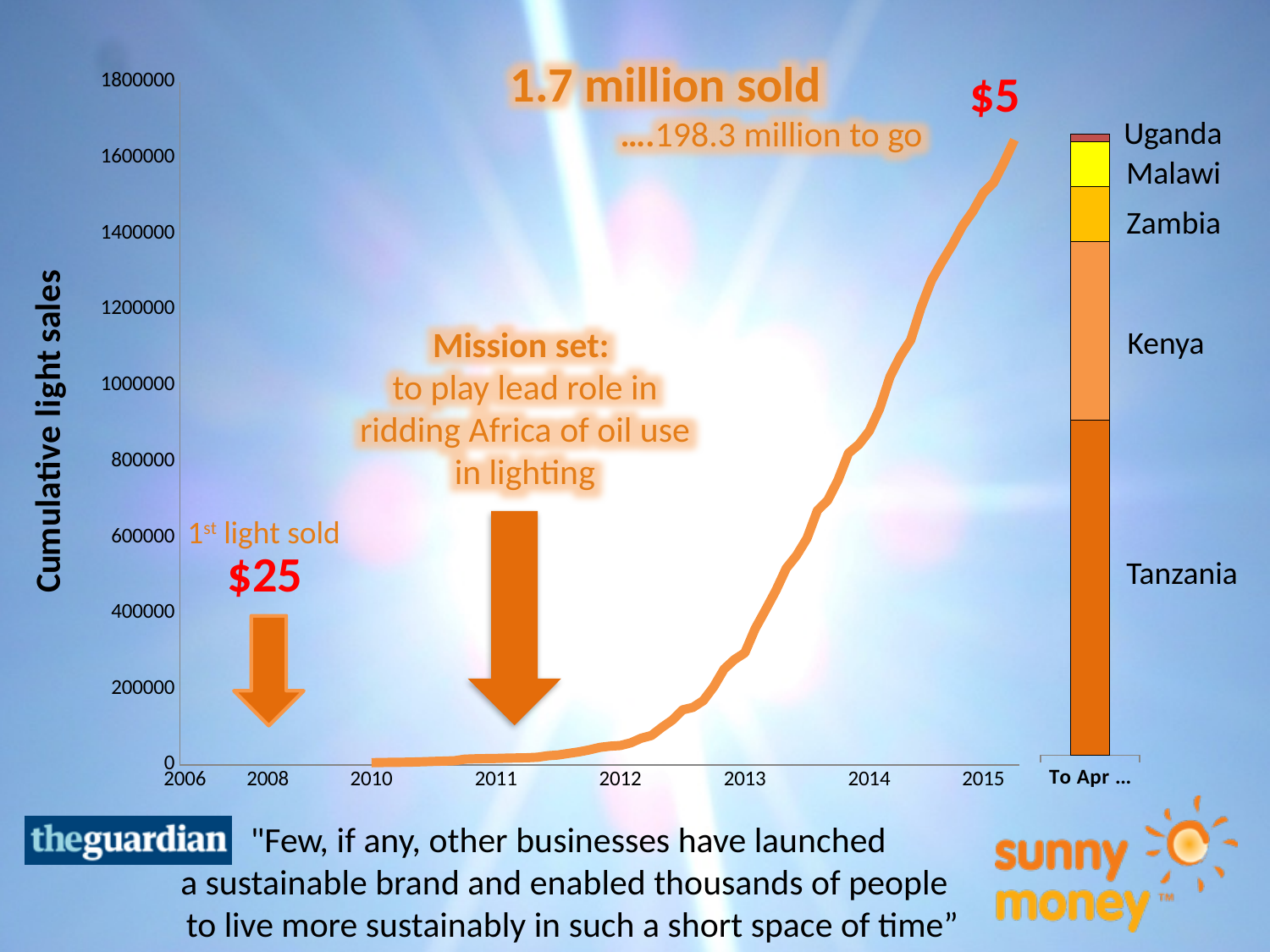
In the main line chart, is the value for 2013 greater or less than 400000? less In the main line chart, do cumulative light sales rise or fall from 2010 to 2015? rise In the main line chart, is the value for 2012 greater or less than 200000? less What kind of chart is the main chart showing cumulative light sales? line chart In the main line chart, is the value for 2014 greater or less than 600000? greater What is the highest tick value shown on the y axis of the main line chart? 1800000 In the stacked bar on the right, which country has the smallest segment? Uganda How many countries are labelled on the stacked bar on the right? 5 What is the label on the y axis of the main line chart? Cumulative light sales In the main line chart, which year has the larger cumulative light sales, 2013 or 2014? 2014 In the stacked bar on the right, which country has the largest segment? Tanzania